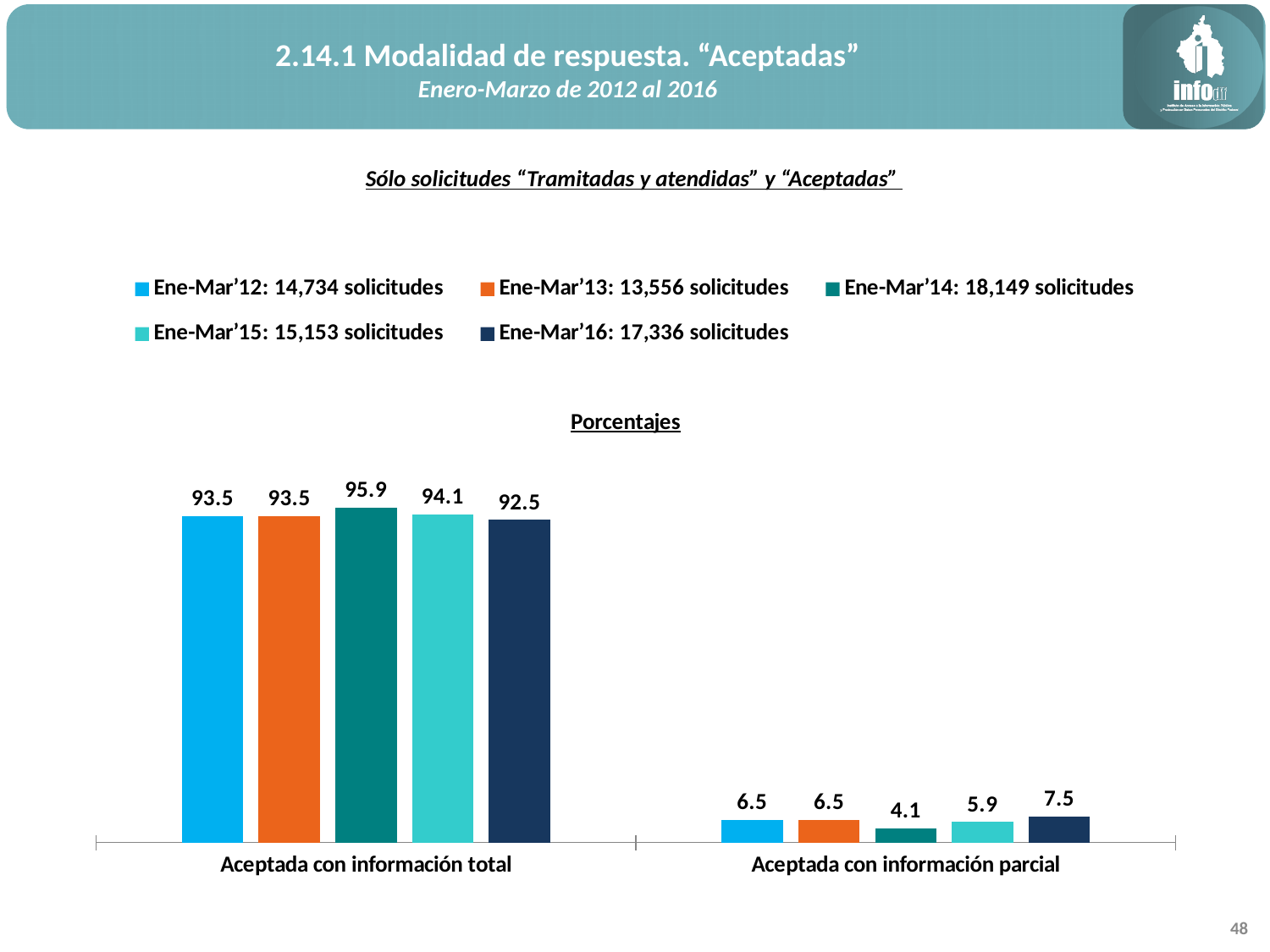
How many categories are shown on the x axis? 2 What is the value for Ene-Mar'14 in the "Aceptada con información total" category? 95.9 Which series has the highest value in the "Aceptada con información total" category? Ene-Mar'14 What kind of chart is shown on the slide? Bar chart What is the difference between the Ene-Mar'14 and Ene-Mar'16 values in the "Aceptada con información total" category? 3.4 What is the value for Ene-Mar'12 in the "Aceptada con información total" category? 93.5 Which is larger in the "Aceptada con información parcial" category: Ene-Mar'15 or Ene-Mar'16? Ene-Mar'16 How many series does the legend list? 5 What is the value for Ene-Mar'16 in the "Aceptada con información parcial" category? 7.5 What is the title shown above the chart? Porcentajes According to the legend, how many solicitudes were there in Ene-Mar'14? 18,149 Which series has the lowest value in the "Aceptada con información parcial" category? Ene-Mar'14